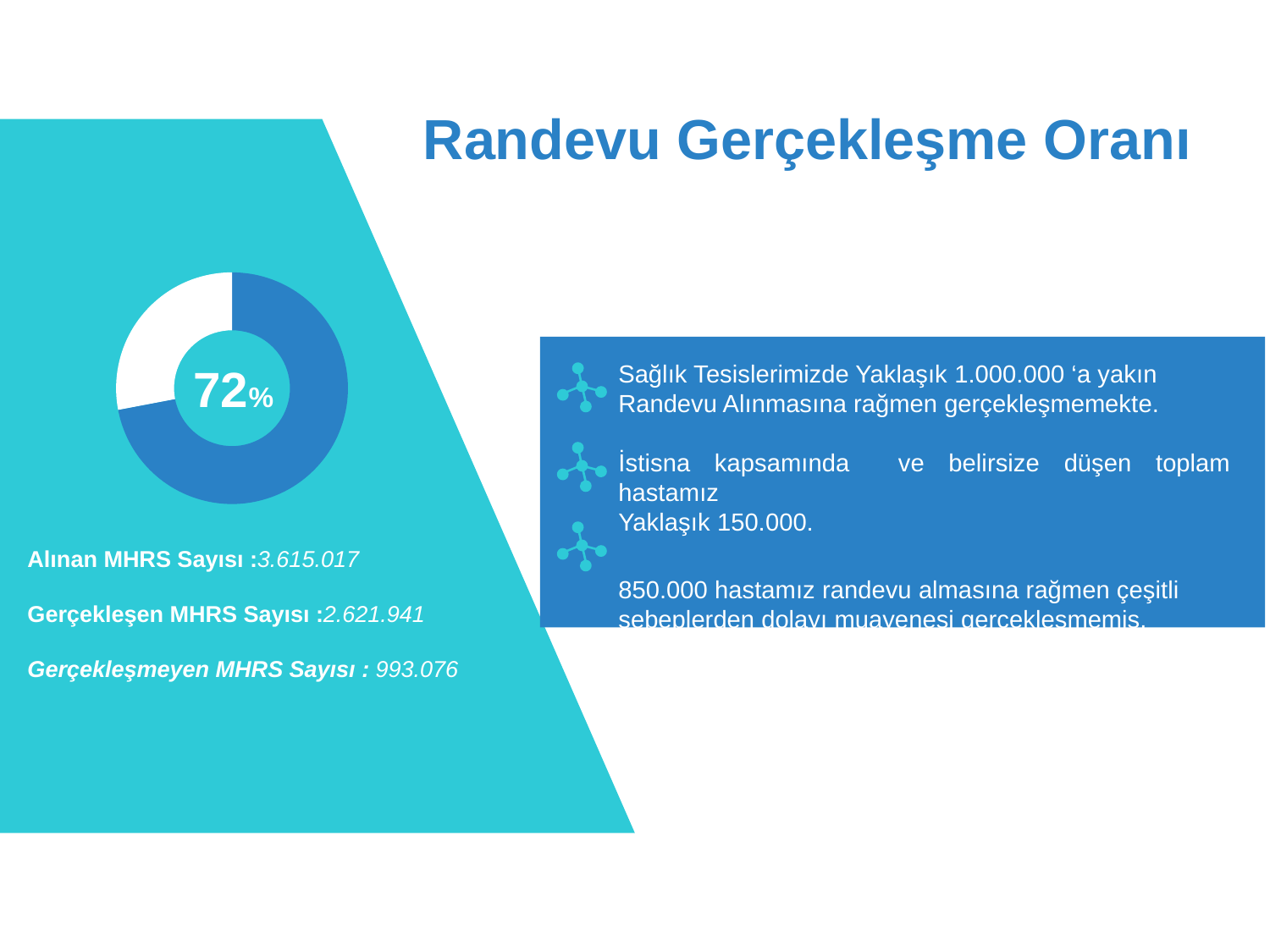
What percentage is printed in the centre of the donut chart? 72% What kind of chart is shown on the slide? Donut (pie) chart Which is larger, 'Gerçekleşen MHRS Sayısı' or 'Gerçekleşmeyen MHRS Sayısı'? Gerçekleşen MHRS Sayısı What share of the donut chart does the blue slice represent? 72% What is the value given for 'Alınan MHRS Sayısı' below the chart? 3.615.017 How many slices does the donut chart have? 2 Which slice of the donut chart is larger, the blue one or the white one? The blue one What is the value given for 'Gerçekleşmeyen MHRS Sayısı' below the chart? 993.076 What colour is the larger slice of the donut chart? Blue What is the title of the slide containing the donut chart? Randevu Gerçekleşme Oranı What is the value given for 'Gerçekleşen MHRS Sayısı' below the chart? 2.621.941 Is the blue slice of the donut chart greater or less than 50% of the whole? greater